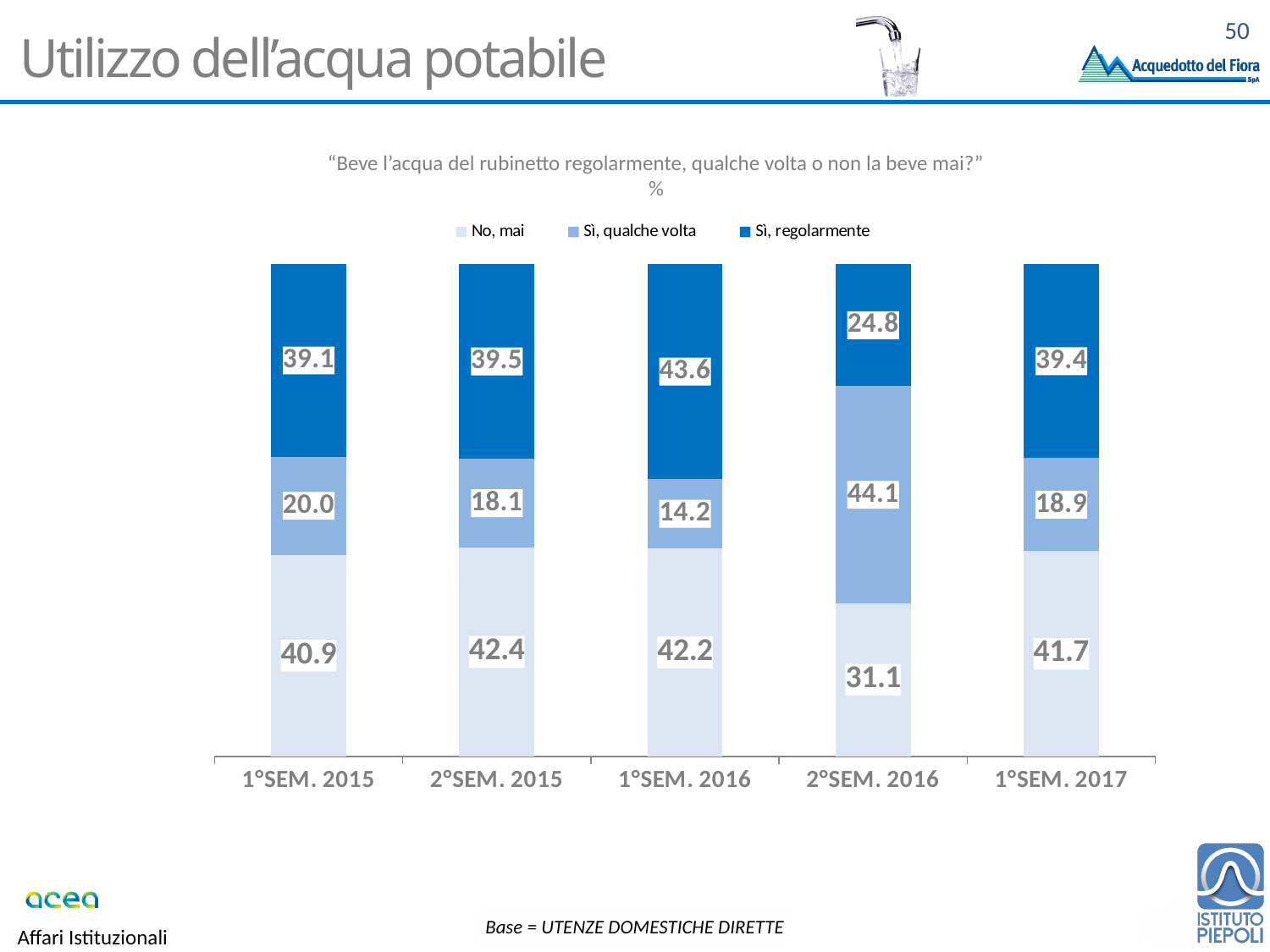
How many periods are shown on the x axis? 5 In which period is the "No, mai" value the highest? 2°SEM. 2015 What kind of chart is shown on the slide? Stacked bar chart In which period is the "Sì, qualche volta" value the highest? 2°SEM. 2016 What is the value for "Sì, regolarmente" in 1°SEM. 2016? 43.6 In which period is the "Sì, regolarmente" value the lowest? 2°SEM. 2016 What is the value for "No, mai" in 2°SEM. 2016? 31.1 What is the difference between the "Sì, qualche volta" values in 2°SEM. 2016 and 1°SEM. 2016? 29.9 Does the "Sì, qualche volta" value rise or fall from 1°SEM. 2015 to 1°SEM. 2016? Fall How many series does the legend list? 3 What is the value for "Sì, qualche volta" in 1°SEM. 2017? 18.9 Which is larger: "No, mai" in 1°SEM. 2015 or "Sì, regolarmente" in 1°SEM. 2015? No, mai in 1°SEM. 2015